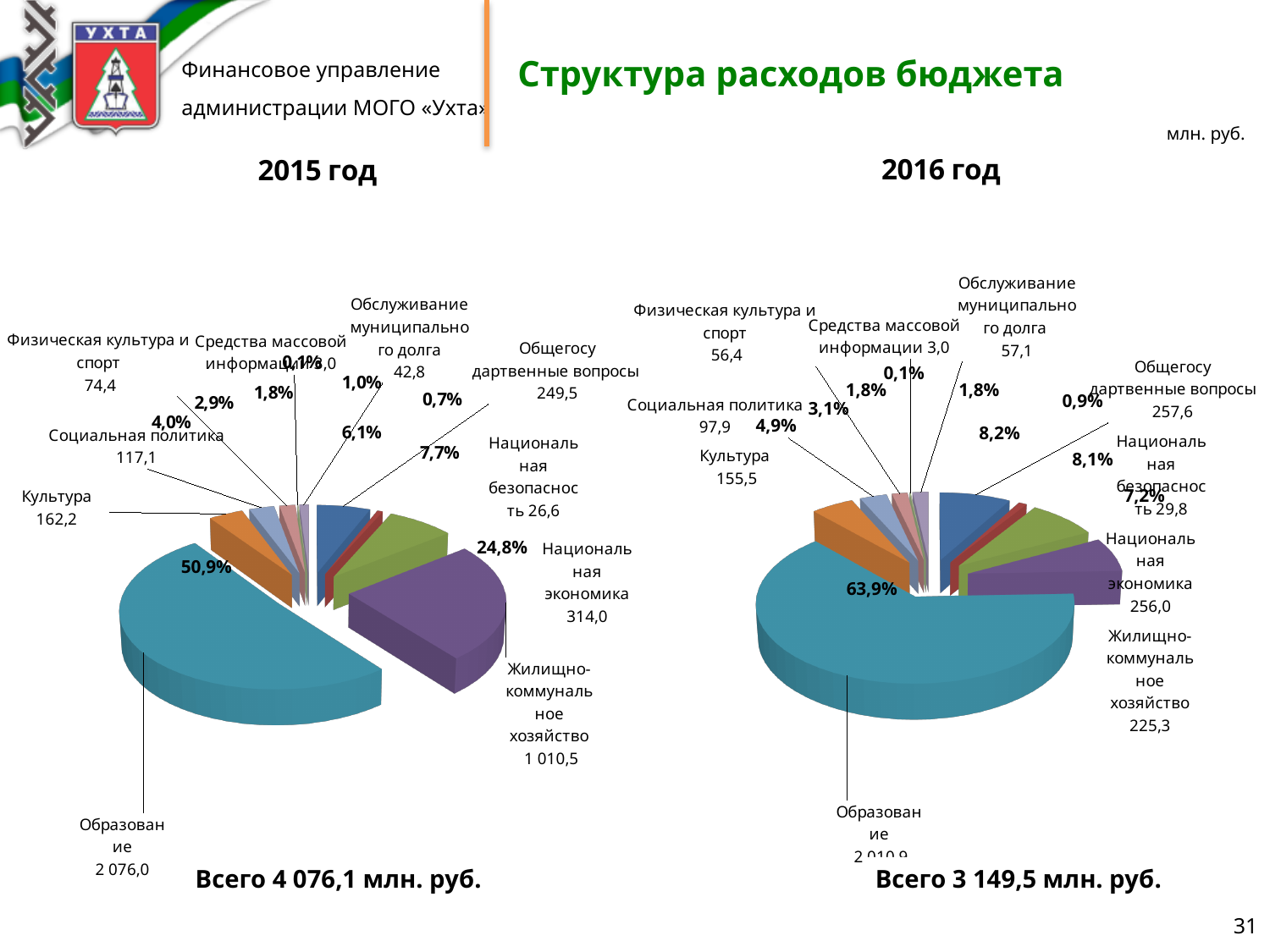
How many categories are shown in the 2015 год pie chart? 10 In the 2016 год chart, what is the value for Обслуживание муниципального долга? 57,1 In the 2015 год chart, what share of the pie does Образование take? 50,9% In the 2016 год chart, what share of the pie does Образование take? 63,9% In the 2016 год chart, which is larger: Национальная экономика or Жилищно-коммунальное хозяйство? Национальная экономика What total is stated below the 2016 год chart? Всего 3 149,5 млн. руб. What kind of chart is used for the 2015 год data? Pie chart In the 2015 год chart, what is the value for Культура? 162,2 In the 2016 год chart, what is the difference between Культура and Социальная политика? 57,6 In the 2016 год chart, what is the value for Общегосударственные вопросы? 257,6 In the 2015 год chart, what is the value for Жилищно-коммунальное хозяйство? 1 010,5 In the 2015 год chart, which category has the smallest value? Средства массовой информации